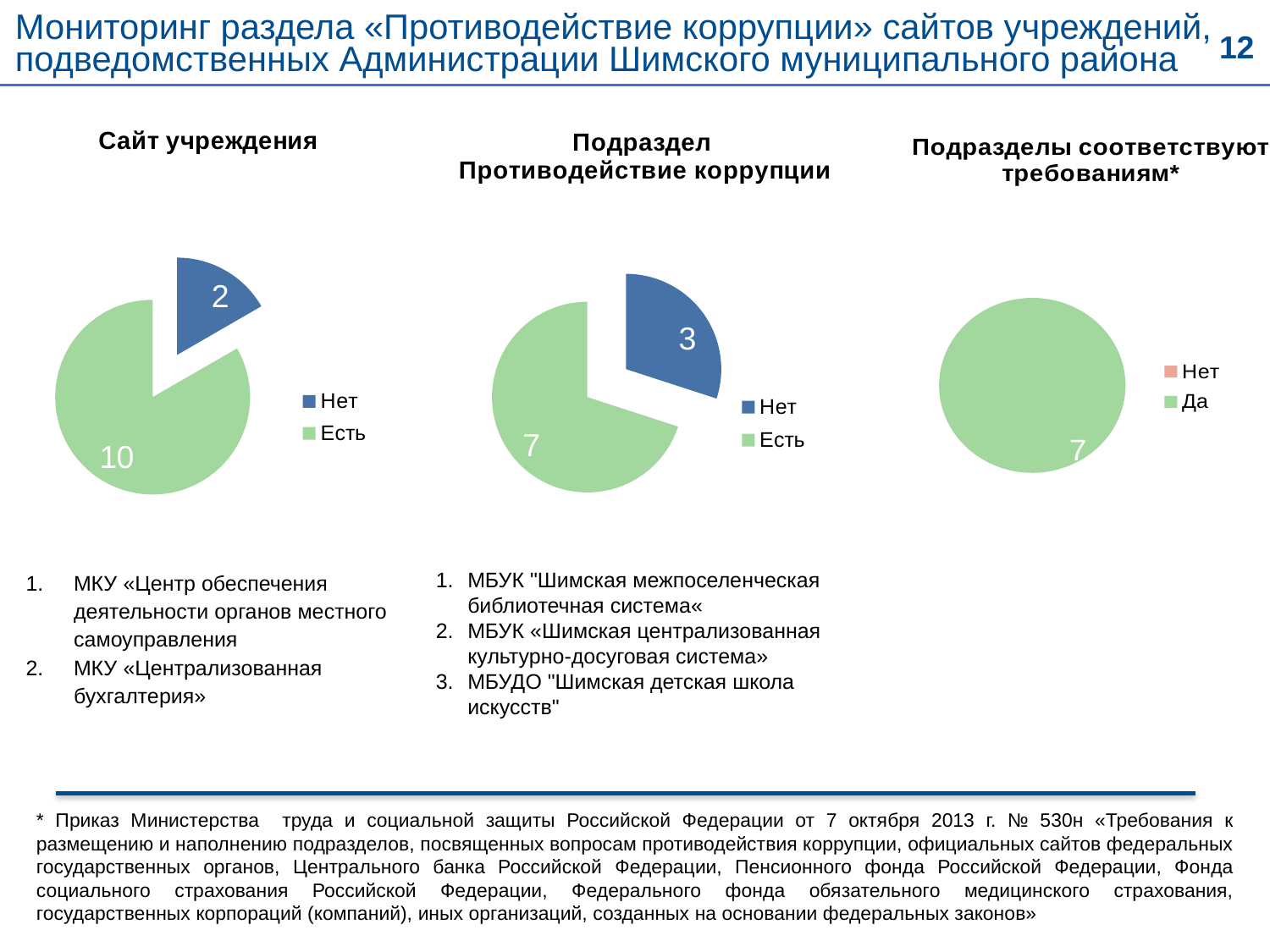
In the chart titled «Подраздел Противодействие коррупции», what is the value for «Нет»? 3 In the chart titled «Сайт учреждения», what is the value for «Нет»? 2 What type of chart is the chart titled «Сайт учреждения»? Pie chart In the chart titled «Подраздел Противодействие коррупции», what is the value for «Есть»? 7 In the chart titled «Сайт учреждения», what is the difference between the values for «Есть» and «Нет»? 8 In the chart titled «Сайт учреждения», what is the value for «Есть»? 10 In the chart titled «Подраздел Противодействие коррупции», what is the difference between the values for «Есть» and «Нет»? 4 In the chart titled «Подраздел Противодействие коррупции», which category has the smallest slice? Нет In the chart titled «Сайт учреждения», which category has the largest slice? Есть How many entries does the legend of the chart titled «Подразделы соответствуют требованиям*» list? 2 In the chart titled «Подраздел Противодействие коррупции», which is larger, «Есть» or «Нет»? Есть In the chart titled «Подразделы соответствуют требованиям*», what is the value for «Да»? 7